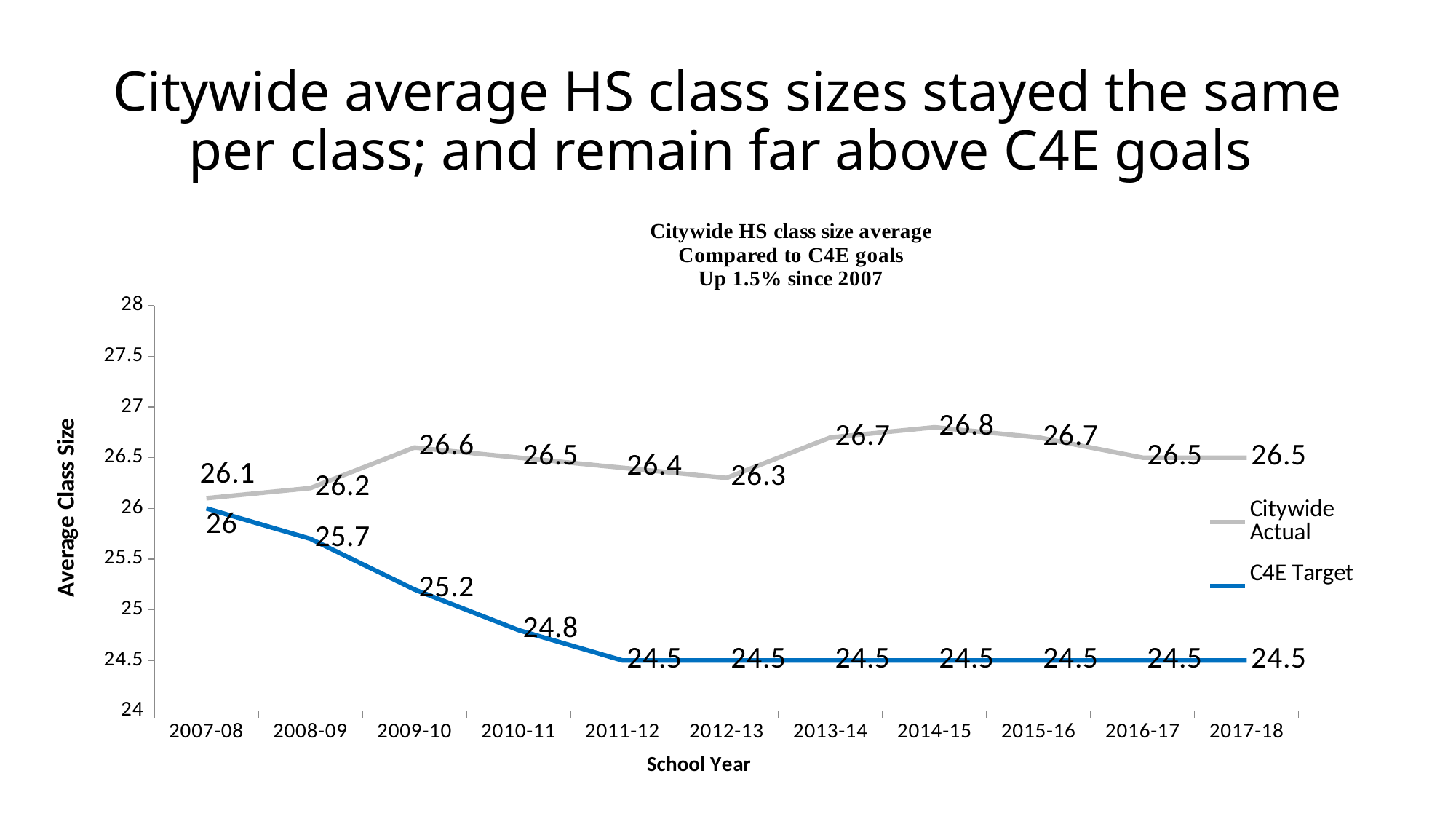
What is the Citywide Actual value for 2007-08? 26.1 What is the C4E Target value for 2008-09? 25.7 What is the label of the y axis? Average Class Size How many series does the legend list? 2 What is the Citywide Actual average class size for 2014-15? 26.8 What is the difference between the Citywide Actual and C4E Target values in 2017-18? 2 How many school years are shown on the x axis? 11 In which school year is the Citywide Actual average class size highest? 2014-15 Which is larger in 2012-13, the Citywide Actual value or the C4E Target value? Citywide Actual What kind of chart is shown on the slide? Line chart In which school year is the Citywide Actual average class size lowest? 2007-08 Does the C4E Target line rise or fall from 2007-08 to 2011-12? Fall